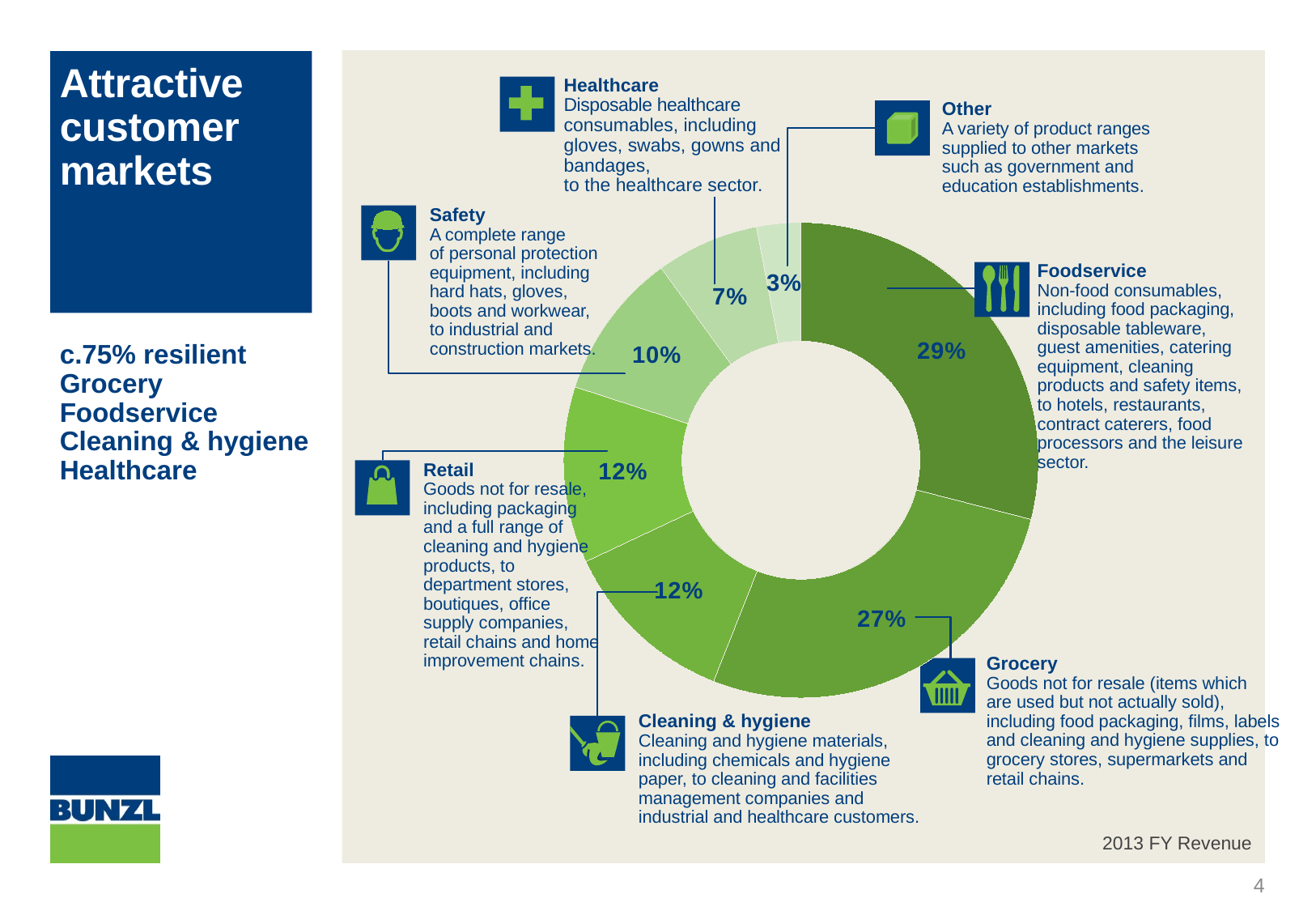
What share of 2013 FY revenue does Grocery account for? 27% What percentage of revenue comes from the Healthcare market? 7% Which customer market has the smallest share of revenue? Other What is the difference in percentage points between the Foodservice and Grocery shares? 2 What share of 2013 FY revenue does Foodservice account for? 29% How many customer market segments are shown in the chart? 7 What kind of chart is used to show the revenue split? Donut (pie) chart What percentage of revenue comes from the Safety market? 10% Which fiscal year's revenue does the chart represent? 2013 FY Revenue What is the combined share of Foodservice and Grocery? 56% Which customer market has the largest share of revenue? Foodservice Which has a larger share of revenue, Safety or Healthcare? Safety